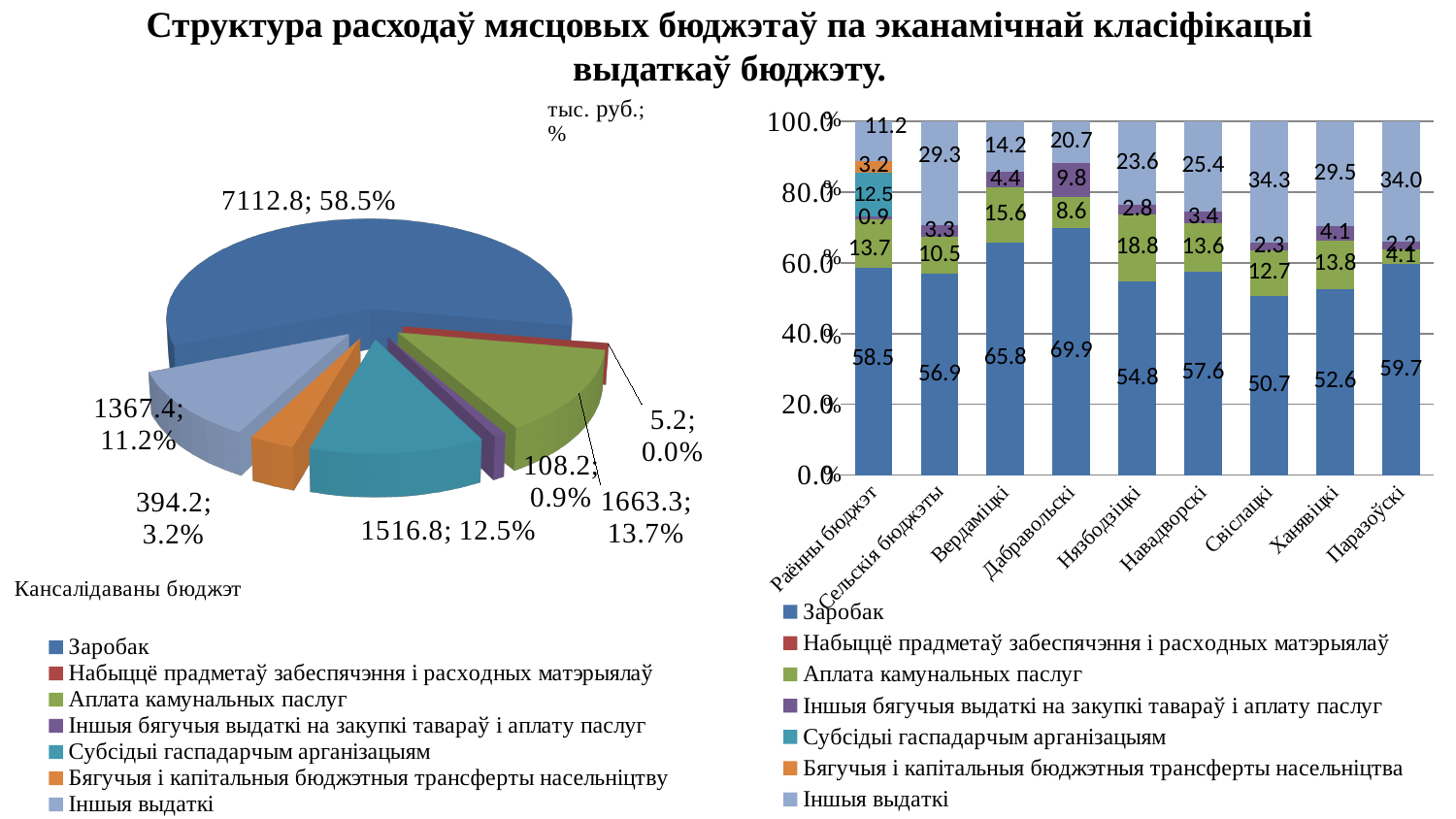
What kind of chart is the right chart? stacked bar chart In the left pie chart (Кансалідаваны бюджэт), what is the data label for the Заробак slice? 7112.8; 58.5% How many slices does the left pie chart (Кансалідаваны бюджэт) have? 7 In the right stacked bar chart, which category has the lowest Заробак value? Свіслацкі In the right stacked bar chart, what is the difference between the Заробак values for Дабравольскі and Свіслацкі? 19.2 In the right stacked bar chart, what is the Іншыя выдаткі value for Свіслацкі? 34.3 How many categories are shown on the x axis of the right stacked bar chart? 9 In the left pie chart (Кансалідаваны бюджэт), what share does Субсідыі гаспадарчым арганізацыям have? 12.5% How many series does the legend of the right stacked bar chart list? 7 In the right stacked bar chart, what is the Заробак value for Дабравольскі? 69.9 In the right stacked bar chart, which category has the highest Заробак value? Дабравольскі What kind of chart is the left chart (Кансалідаваны бюджэт)? pie chart